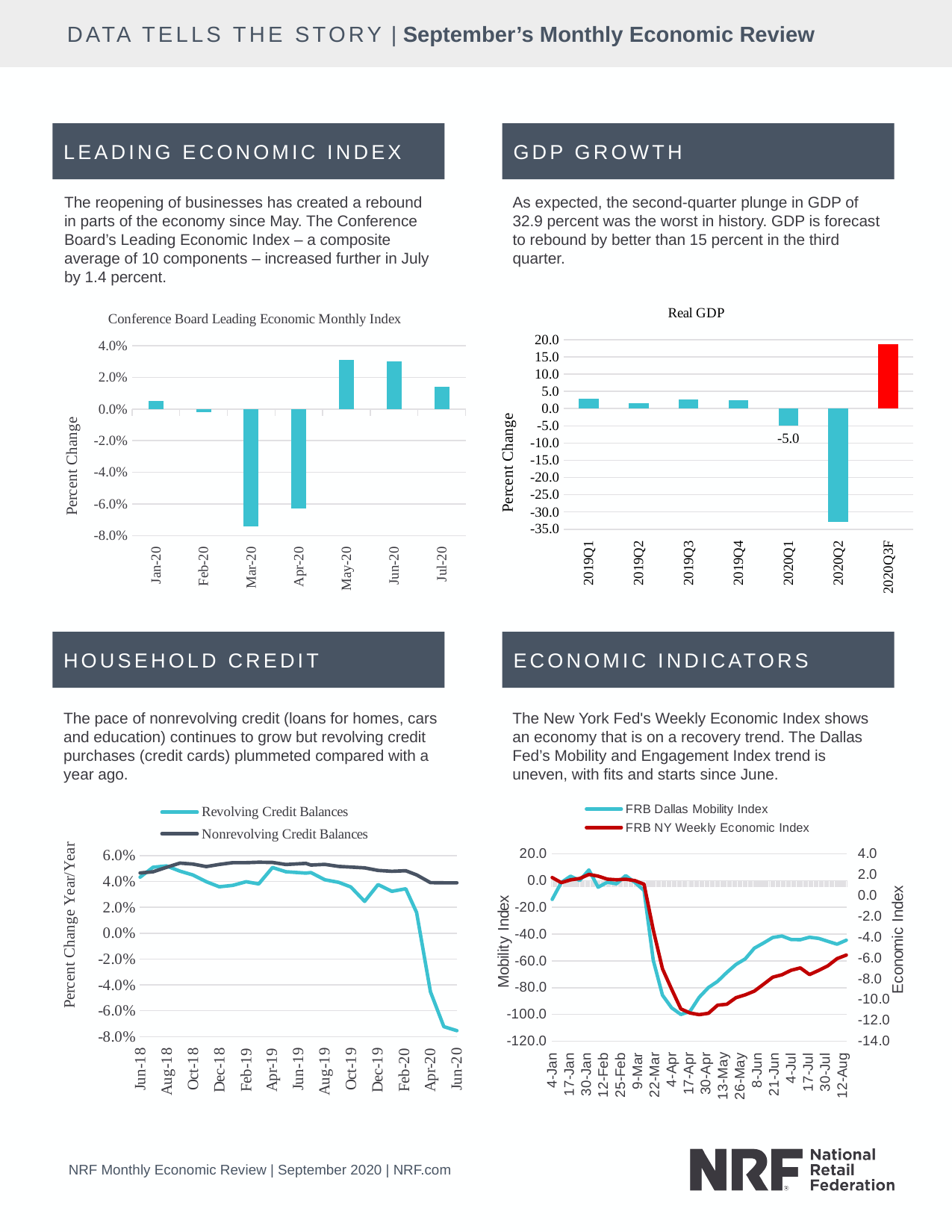
In the Conference Board Leading Economic Monthly Index chart, which is larger, the value for Jan-20 or Feb-20? Jan-20 In the Real GDP chart, which quarter has the lowest value? 2020Q2 In the Household Credit chart, how many series does the legend list? 2 In the Economic Indicators chart, is the FRB Dallas Mobility Index value at 17-Apr greater or less than -80.0? less In the Real GDP chart, which quarter has the highest value? 2020Q3F In the Real GDP chart, what colour is the bar for 2020Q3F? red In the Conference Board Leading Economic Monthly Index chart, how many months are plotted? 7 In the Real GDP chart, what is the value for 2020Q1? -5.0 In the Conference Board Leading Economic Monthly Index chart, which month has the lowest value? Mar-20 In the Conference Board Leading Economic Monthly Index chart, is the value for Mar-20 greater or less than -6.0%? less What type of chart is the Conference Board Leading Economic Monthly Index chart? bar chart In the Real GDP chart, is the value for 2020Q2 greater or less than -30.0? less